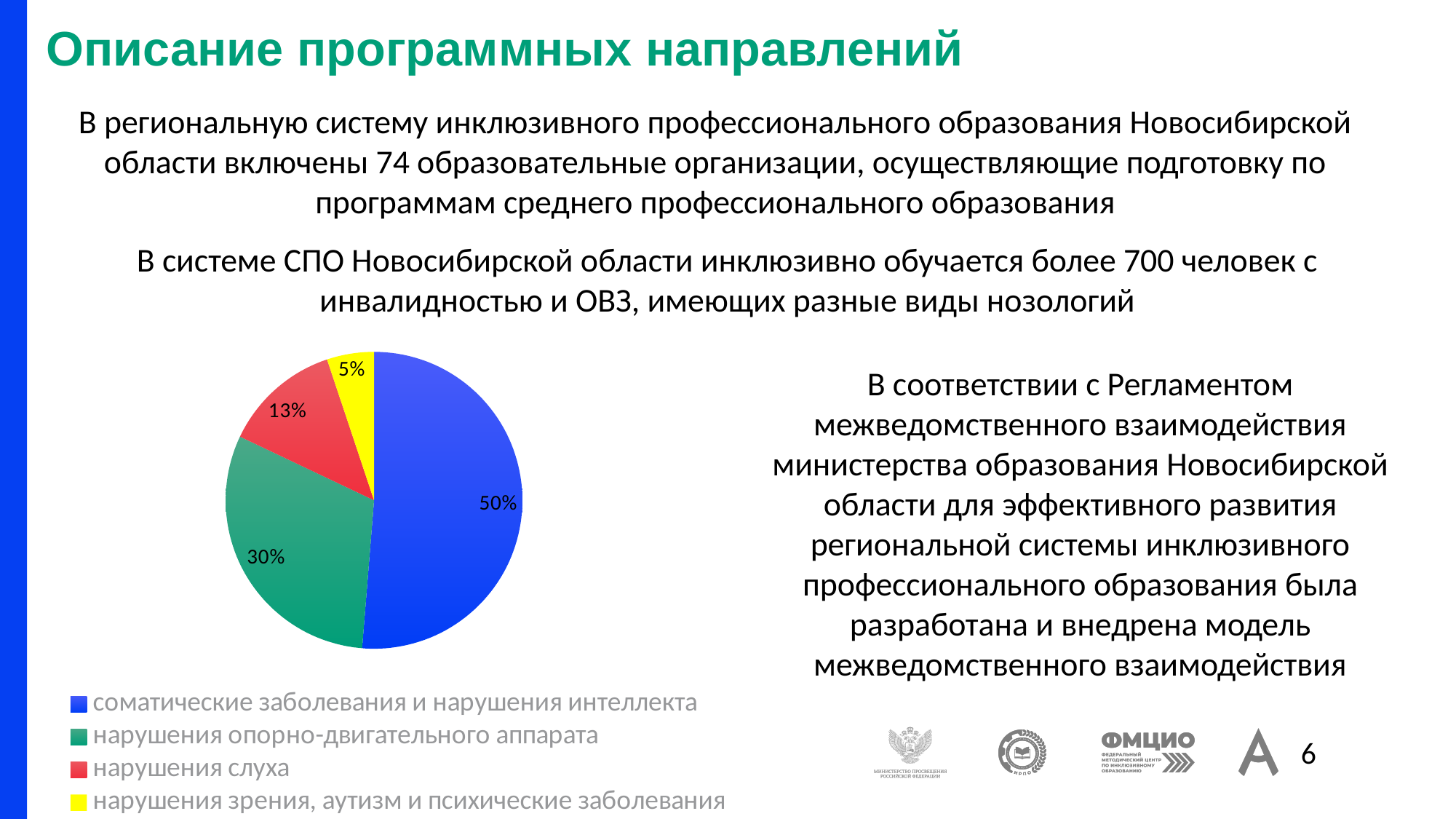
How many slices does the pie chart have? 4 What share of the pie is labelled for "нарушения зрения, аутизм и психические заболевания"? 5% How many entries does the legend of the pie chart list? 4 Which slice is larger: "нарушения слуха" or "нарушения зрения, аутизм и психические заболевания"? нарушения слуха What kind of chart is shown on the slide? pie chart What colour is the slice for "нарушения слуха" in the pie chart? red What share of the pie is labelled for "соматические заболевания и нарушения интеллекта"? 50% Which category has the largest slice of the pie? соматические заболевания и нарушения интеллекта What share of the pie is labelled for "нарушения слуха"? 13% Which category has the smallest slice of the pie? нарушения зрения, аутизм и психические заболевания What share of the pie is labelled for "нарушения опорно-двигательного аппарата"? 30% What is the difference in percentage points between the slices for "соматические заболевания и нарушения интеллекта" and "нарушения опорно-двигательного аппарата"? 20 percentage points